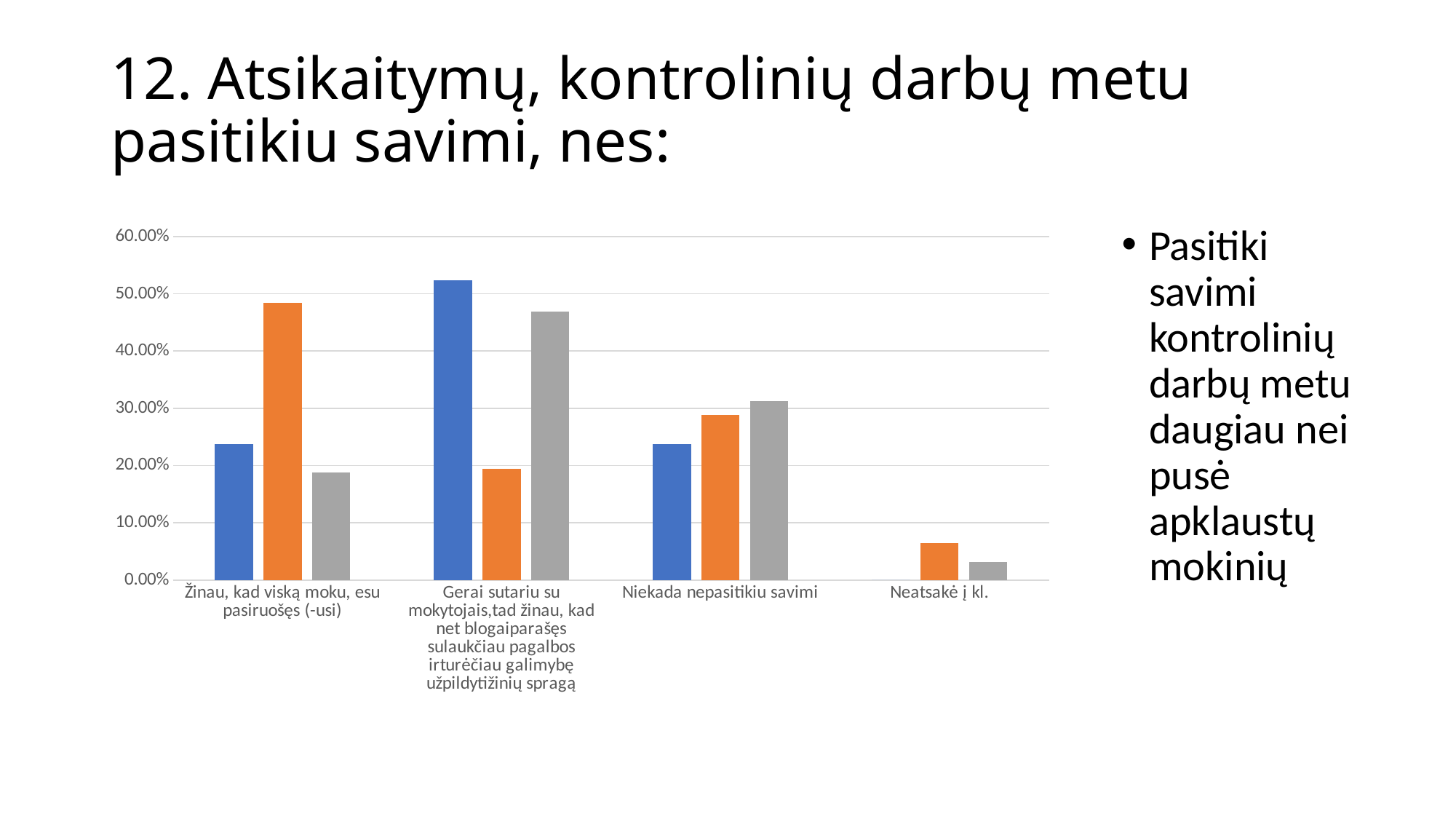
Which category has the tallest orange bar? Žinau, kad viską moku, esu pasiruošęs (-usi) For "Niekada nepasitikiu savimi", is the blue bar or the gray bar taller? gray How many categories are shown on the x axis of the chart? 4 Which category has the lowest orange bar? Neatsakė į kl. For "Žinau, kad viską moku, esu pasiruošęs (-usi)", is the orange bar or the gray bar taller? orange Is the orange bar for "Žinau, kad viską moku, esu pasiruošęs (-usi)" greater or less than 40.00%? greater What is the highest value shown on the chart's vertical axis? 60.00% Is the gray bar for "Gerai sutariu su mokytojais..." greater or less than 40.00%? greater What kind of chart is shown on the slide? bar chart Is the gray bar for "Neatsakė į kl." greater or less than 10.00%? less Which category has the tallest blue bar? Gerai sutariu su mokytojais, tad žinau, kad net blogai parašęs sulaukčiau pagalbos ir turėčiau galimybę užpildyti žinių spragą